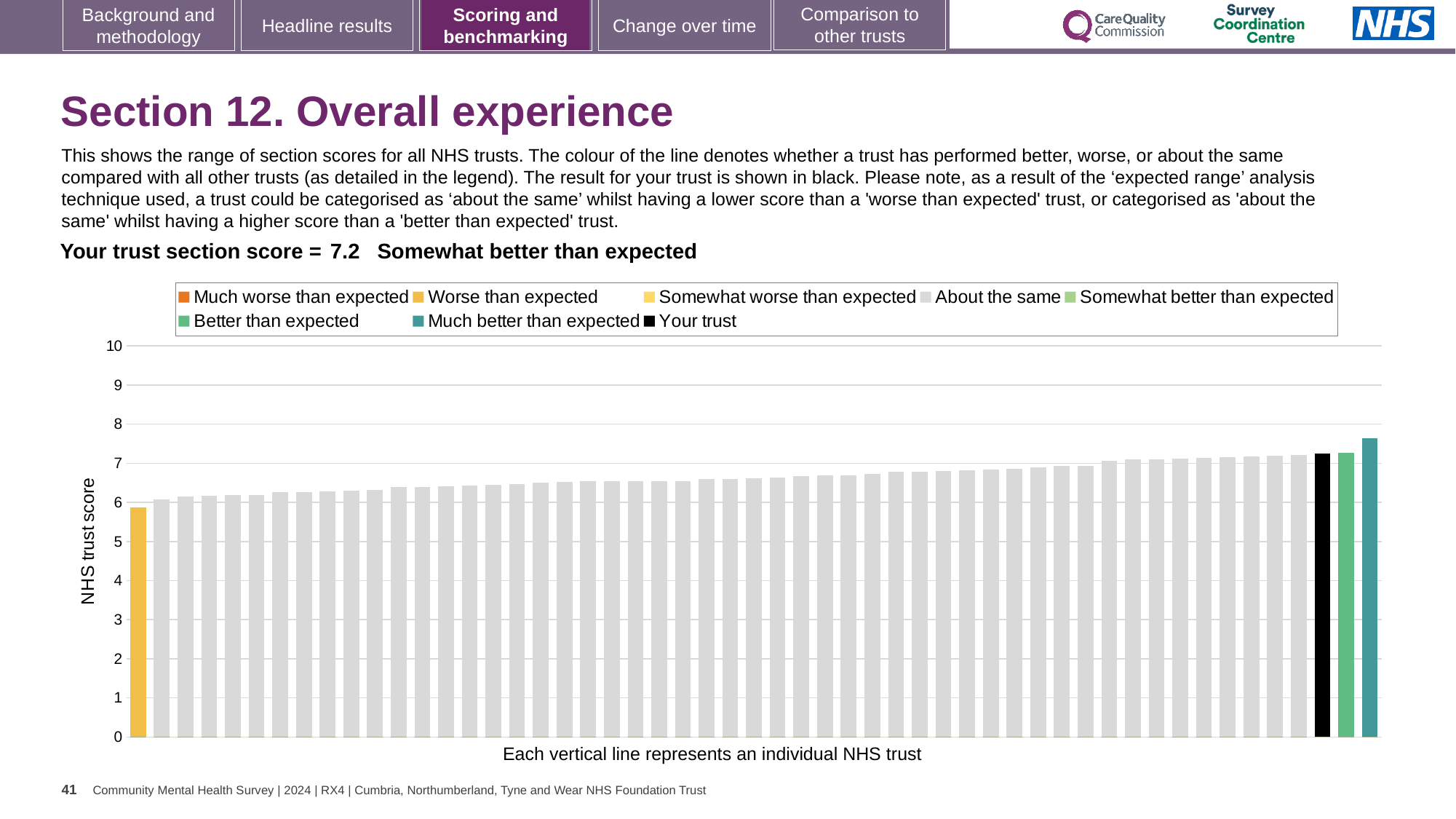
Which is higher, the black 'Your trust' bar or the yellow 'Worse than expected' bar? the black 'Your trust' bar Is the value of the leftmost (yellow) bar greater or less than 5? greater What kind of chart is shown on the slide? bar chart Is the value of the tallest bar on the chart greater or less than 8? less Is the value of the tallest bar (the teal 'Much better than expected' trust) greater or less than 7? greater What is the title of the vertical axis? NHS trust score Which performance category is your trust placed in for this section? Somewhat better than expected Do the bar values rise or fall from left to right along the x axis? rise How many entries does the chart legend list? 8 Which legend category does the lowest bar on the chart belong to? Worse than expected What is the section score for your trust shown on the slide? 7.2 Which legend category does the highest bar on the chart belong to? Much better than expected